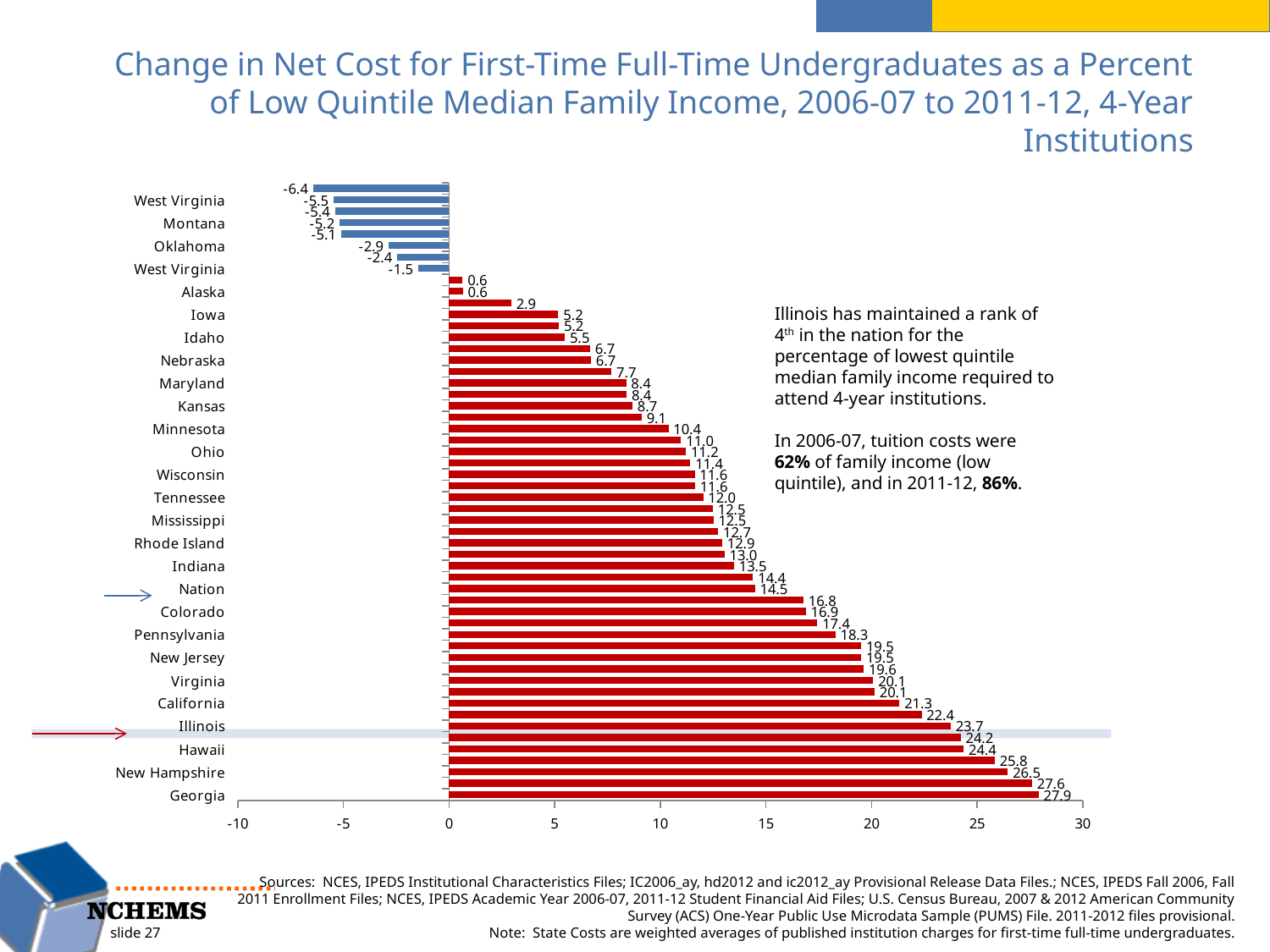
Is the value for Georgia greater or less than 25? greater What is the value for New Hampshire? 26.5 Which labeled category has the highest value? Georgia What is the value for Georgia? 27.9 What is the value for the Nation? 14.5 What is the value for Illinois? 23.7 Which is larger, the value for Illinois or the value for the Nation? Illinois What colour are the bars with negative values? blue What kind of chart is shown on the slide? bar chart What is the difference between the values for Georgia and Illinois? 4.2 What is the value for Alaska? 0.6 What is the lowest value shown on the chart? -6.4